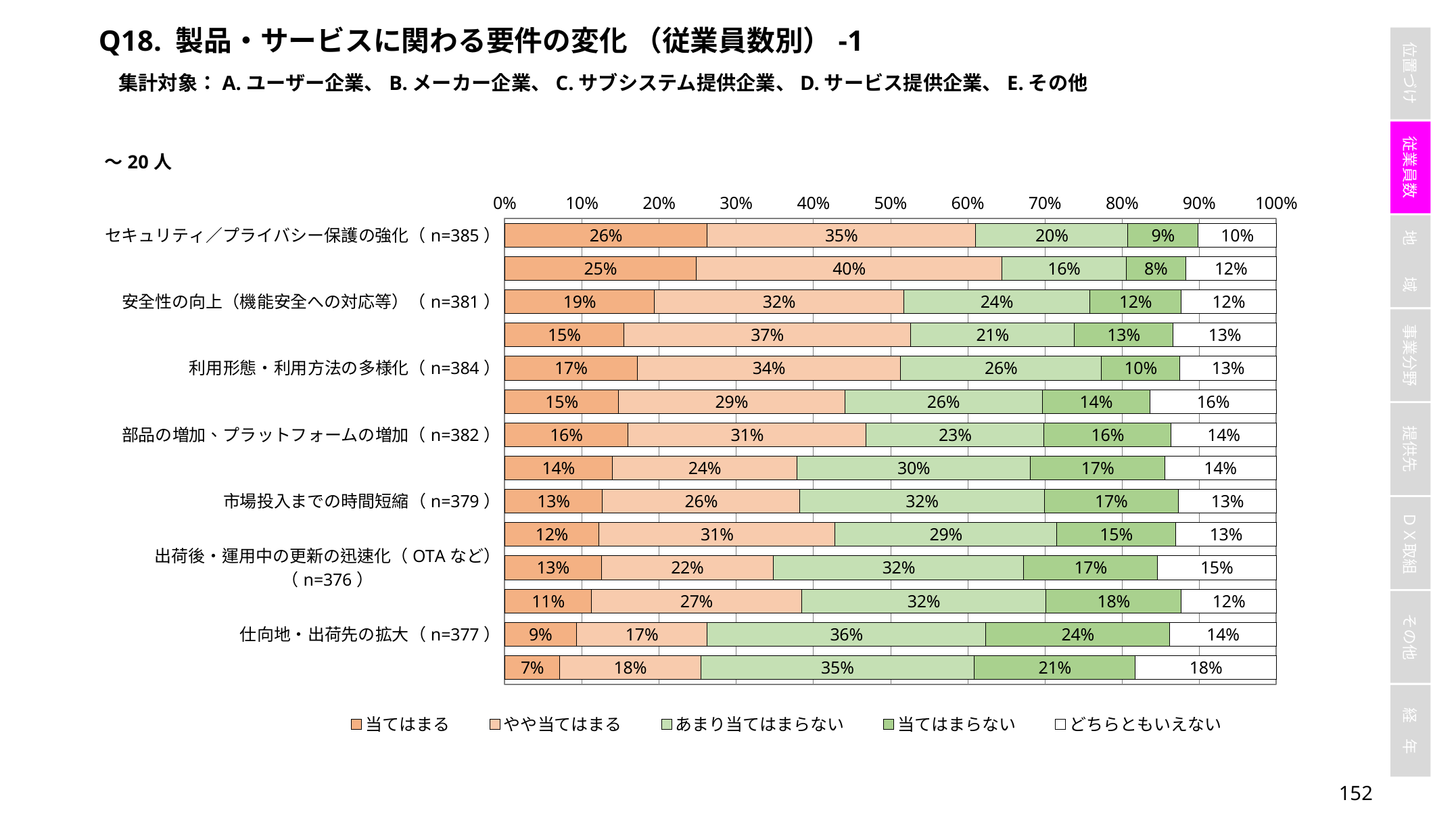
What is the total of the stacked bar next to the label 部品の増加、プラットフォームの増加（n=382）? 100% In the bar next to the label 出荷後・運用中の更新の迅速化（OTAなど）（n=376）, what is the value for どちらともいえない? 15% Among the labeled categories, which has the highest 当てはまる value? セキュリティ／プライバシー保護の強化（n=385） What kind of chart is shown on the slide? Stacked bar chart How many series does the legend list? 5 In the bar next to the label 仕向地・出荷先の拡大（n=377）, what is the value for あまり当てはまらない? 36% Which has the larger 当てはまる value: the bar labeled 安全性の向上（機能安全への対応等）（n=381） or the bar labeled 利用形態・利用方法の多様化（n=384）? 安全性の向上（機能安全への対応等）（n=381） In the bar next to the label セキュリティ／プライバシー保護の強化（n=385）, what is the value for 当てはまる? 26% What is the difference in percentage points between the 当てはまる value for セキュリティ／プライバシー保護の強化（n=385） and for 仕向地・出荷先の拡大（n=377）? 17 In the bar next to the label 市場投入までの時間短縮（n=379）, what is the value for やや当てはまる? 26% Among the labeled categories, which has the lowest 当てはまる value? 仕向地・出荷先の拡大（n=377） Which legend entry is shown in white (unfilled)? どちらともいえない